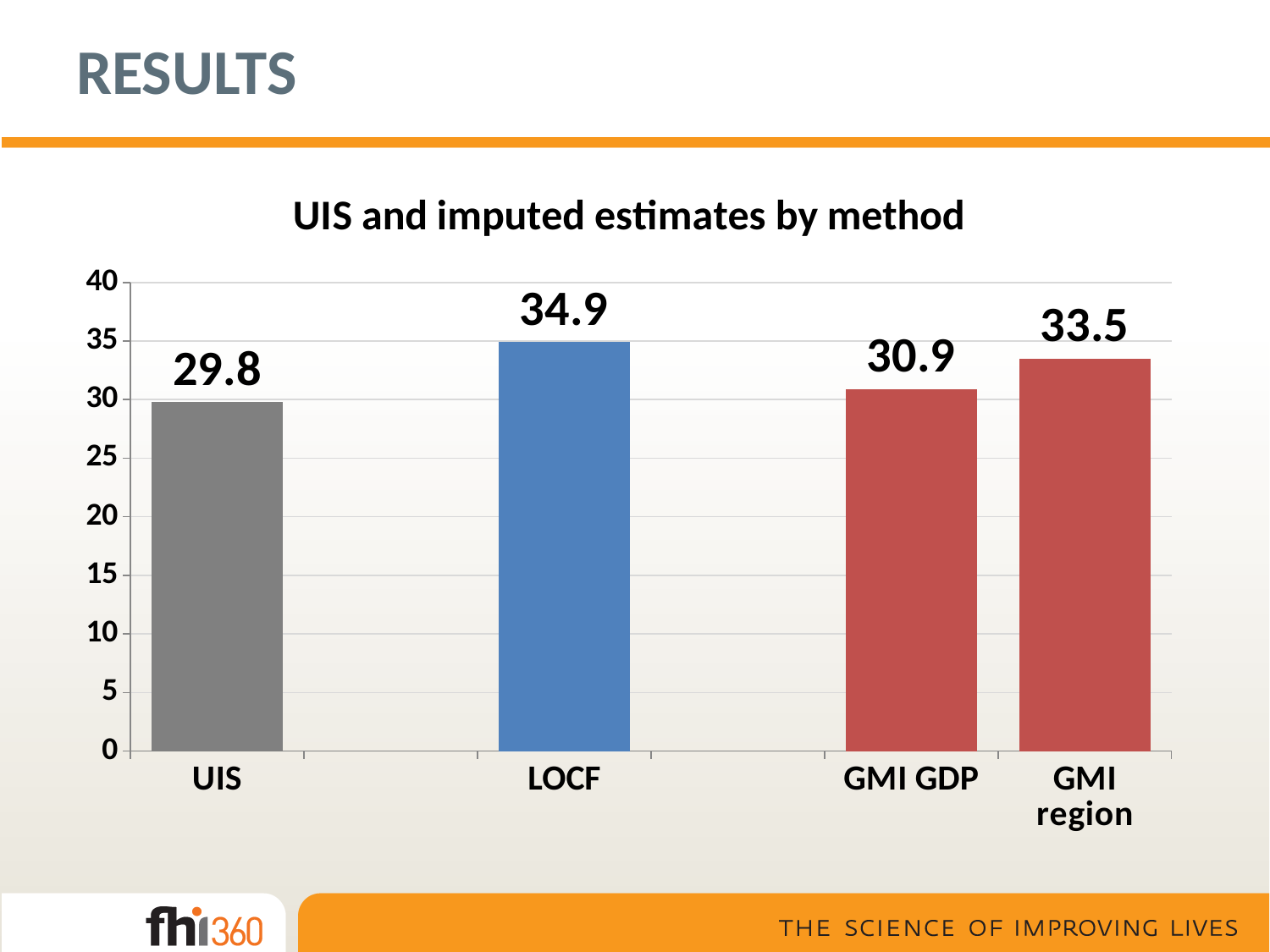
Which is larger, the value for GMI GDP or the value for GMI region? GMI region What is the difference between the LOCF value and the UIS value? 5.1 What is the value for UIS? 29.8 What is the difference between the GMI region value and the GMI GDP value? 2.6 What is the title of the chart? UIS and imputed estimates by method How many bars are shown in the chart? 4 What is the value for LOCF? 34.9 What is the value for GMI GDP? 30.9 What is the value for GMI region? 33.5 Which method has the highest value? LOCF Which method has the lowest value? UIS Is the value for UIS greater or less than 30? less